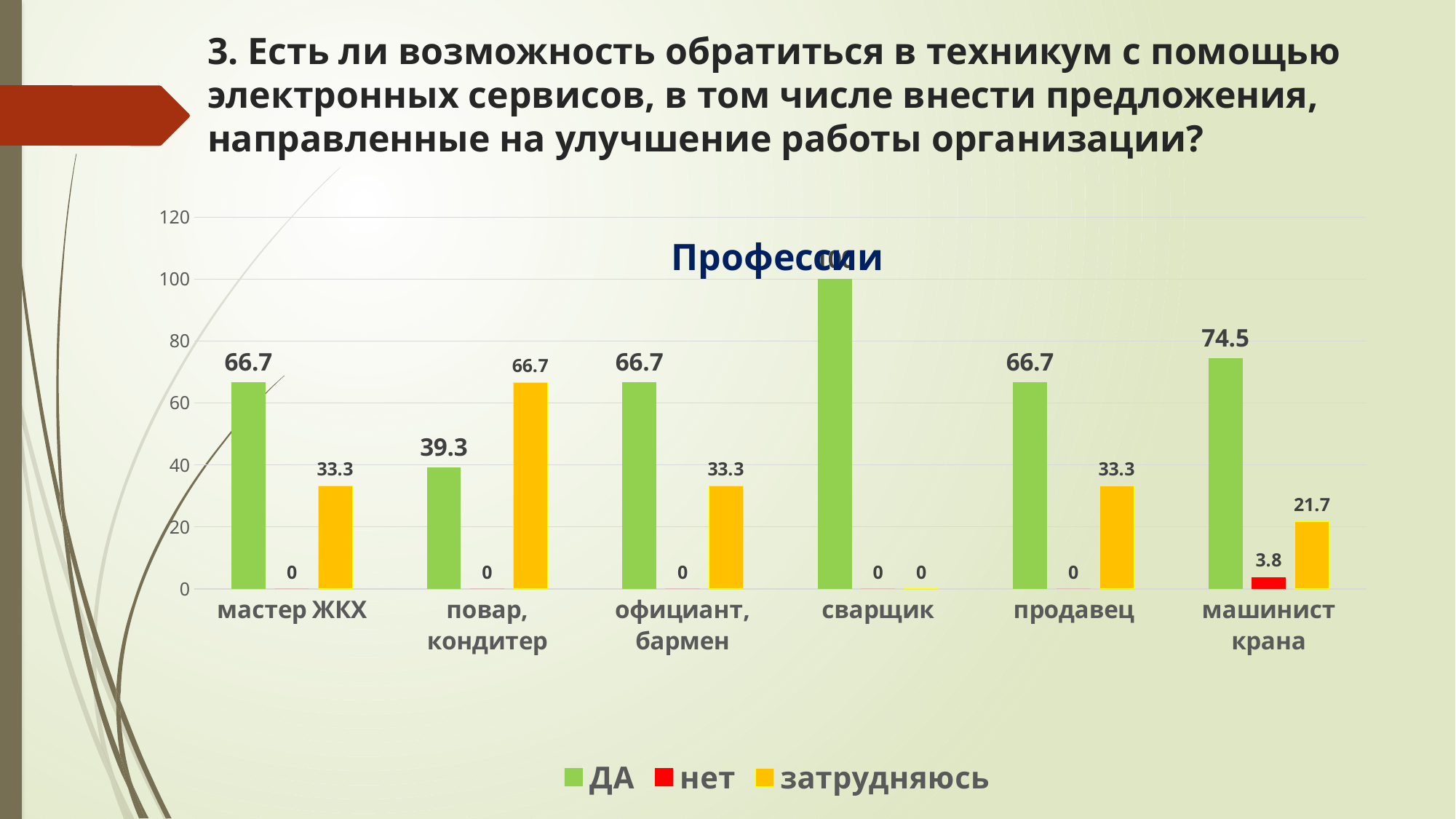
Is the ДА value for сварщик greater or less than 80? greater What type of chart is shown on the slide? bar chart What is the value of нет for машинист крана? 3.8 How many profession categories are shown on the x axis? 6 Which profession has the lowest ДА value? повар, кондитер What is the value of ДА for машинист крана? 74.5 What is the difference between the ДА value for машинист крана and the ДА value for продавец? 7.8 For повар, кондитер, which is larger: ДА or затрудняюсь? затрудняюсь What is the title of the chart? Профессии What is the value of затрудняюсь for повар, кондитер? 66.7 How many series does the chart legend list? 3 Which profession has the highest ДА value? сварщик